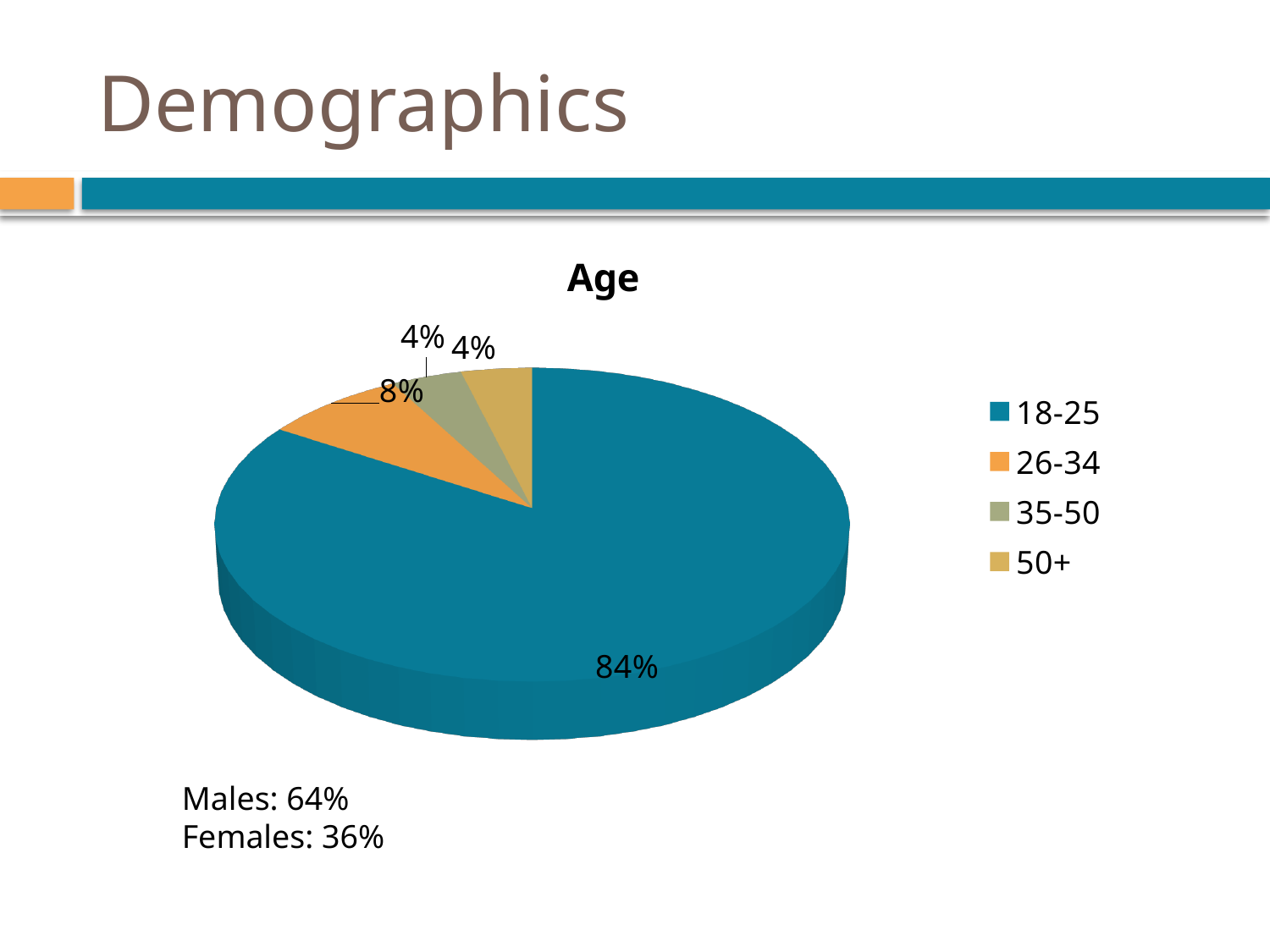
What is the difference between the shares of the 26-34 and 50+ age groups? 4% What is the title of the chart? Age What share of the pie does the 26-34 age group have? 8% What colour is the slice for the 18-25 age group? teal blue What share of the pie does the 50+ age group have? 4% How many age groups does the legend list? 4 What is the difference between the shares of the 18-25 and 26-34 age groups? 76% What share of the pie does the 18-25 age group have? 84% What kind of chart is shown on the slide? pie chart Which age group has the largest share of the pie? 18-25 Which is larger, the share for 26-34 or the share for 35-50? 26-34